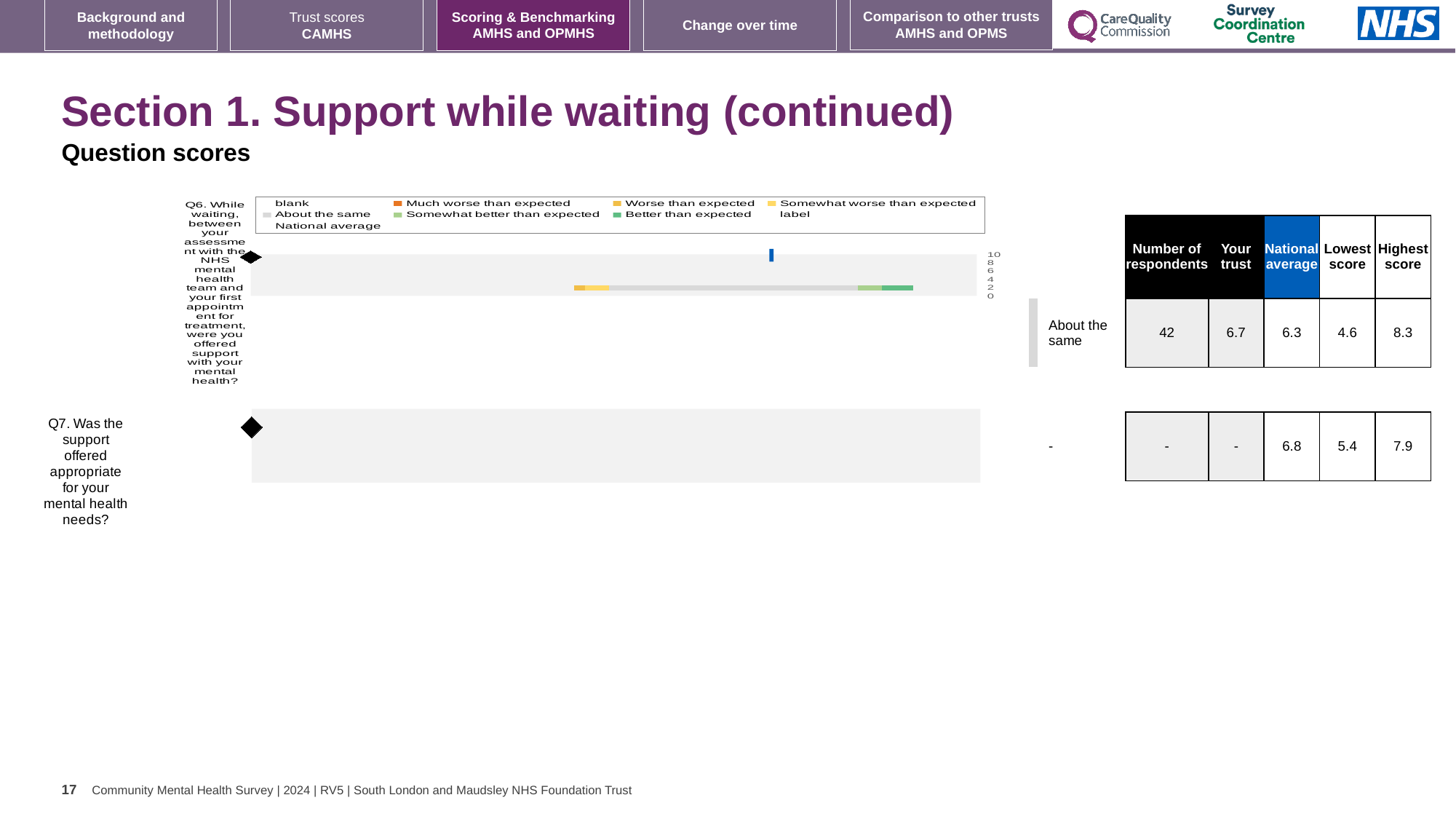
Is the trust's Q6 score higher or lower than the national average for Q6? higher What is the lowest score for Q6? 4.6 What kind of chart is used to show the Q6 question score? bar chart Which legend entry is shown in dark green on the Q6 chart? Better than expected What is the national average score for Q7? 6.8 What is the highest score for Q6? 8.3 What is the highest value shown on the chart's score axis? 10 What is the number of respondents for Q6? 42 According to the slide, how is the trust's Q6 score categorised relative to expectations? About the same What is the difference between the highest score and the lowest score for Q6? 3.7 What is the trust's score for Q6? 6.7 What is the national average score for Q6? 6.3